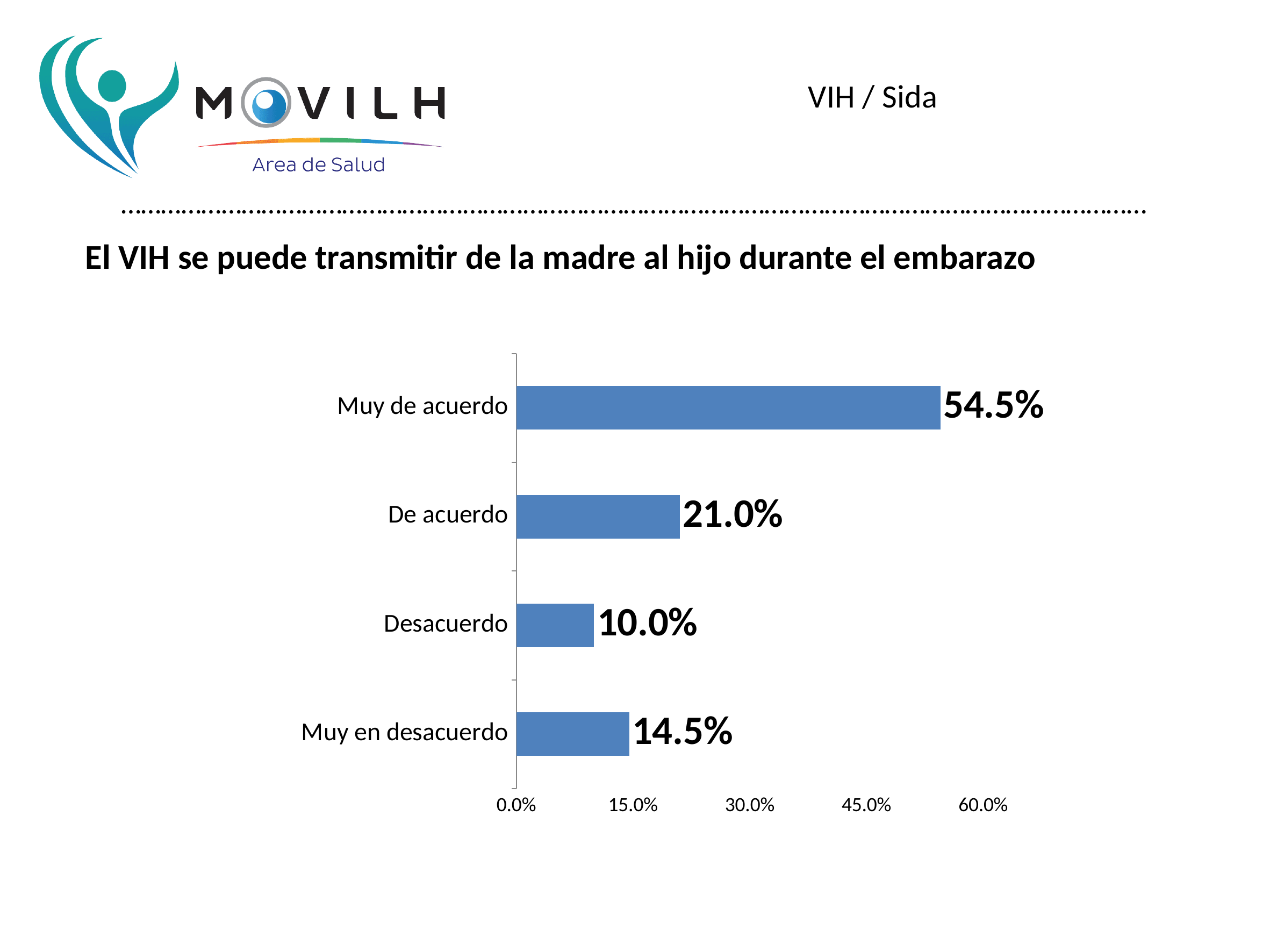
Is the value for "Muy de acuerdo" greater or less than 45.0%? greater What is the value for "Muy de acuerdo"? 54.5% What is the value for "De acuerdo"? 21.0% Which category has the highest value? Muy de acuerdo What is the value for "Desacuerdo"? 10.0% Which category has the lowest value? Desacuerdo What kind of chart is shown on the slide? bar chart How many categories are shown in the chart? 4 What is the title of the chart on the slide? El VIH se puede transmitir de la madre al hijo durante el embarazo What is the difference between the values for "Muy de acuerdo" and "De acuerdo"? 33.5% Which is larger, the value for "Muy en desacuerdo" or the value for "Desacuerdo"? Muy en desacuerdo What is the value for "Muy en desacuerdo"? 14.5%